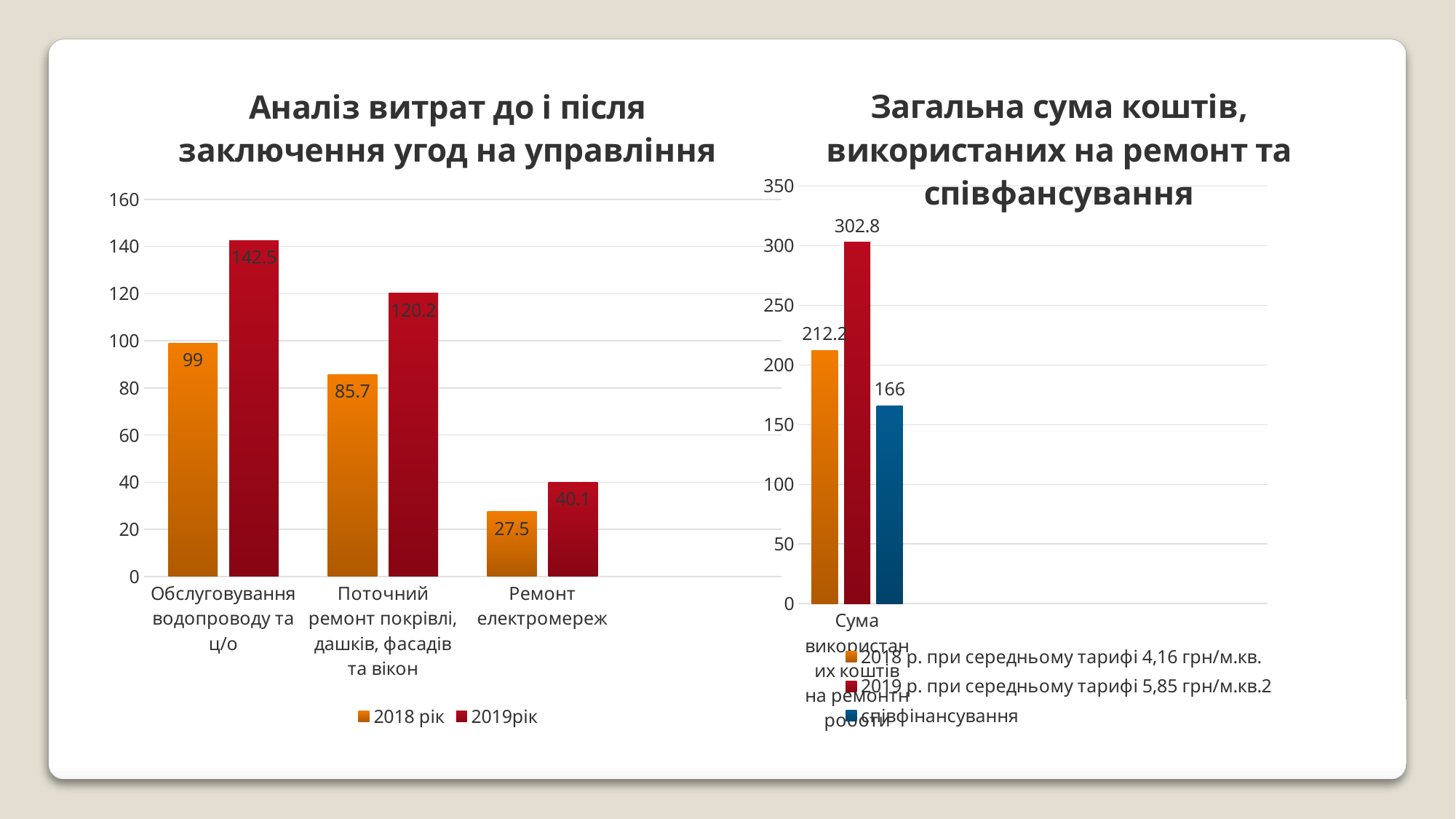
In the left chart 'Аналіз витрат до і після заключення угод на управління', what is the value for 2019рік for 'Обслуговування водопроводу та ц/о'? 142.5 In the right chart 'Загальна сума коштів, використаних на ремонт та співфансування', what is the difference between the 2019 р. value and the 2018 р. value? 90.6 In the left chart 'Аналіз витрат до і після заключення угод на управління', which category has the lowest value for 2019рік? Ремонт електромереж In the right chart 'Загальна сума коштів, використаних на ремонт та співфансування', what is the value for 'співфінансування'? 166 In the left chart 'Аналіз витрат до і після заключення угод на управління', do the 2018 рік values rise or fall from left to right across the categories? fall What kind of chart is the right chart 'Загальна сума коштів, використаних на ремонт та співфансування'? bar chart In the left chart 'Аналіз витрат до і після заключення угод на управління', what is the value for 2018 рік for 'Ремонт електромереж'? 27.5 In the left chart 'Аналіз витрат до і після заключення угод на управління', how many categories are shown on the x axis? 3 In the left chart 'Аналіз витрат до і після заключення угод на управління', which is larger for 'Обслуговування водопроводу та ц/о': the 2018 рік value or the 2019рік value? 2019рік In the right chart 'Загальна сума коштів, використаних на ремонт та співфансування', which series has the highest value? 2019 р. при середньому тарифі 5,85 грн/м.кв.2 In the left chart 'Аналіз витрат до і після заключення угод на управління', how many series does the legend list? 2 In the left chart 'Аналіз витрат до і після заключення угод на управління', what is the difference between the 2019рік and 2018 рік values for 'Поточний ремонт покрівлі, дашків, фасадів та вікон'? 34.5